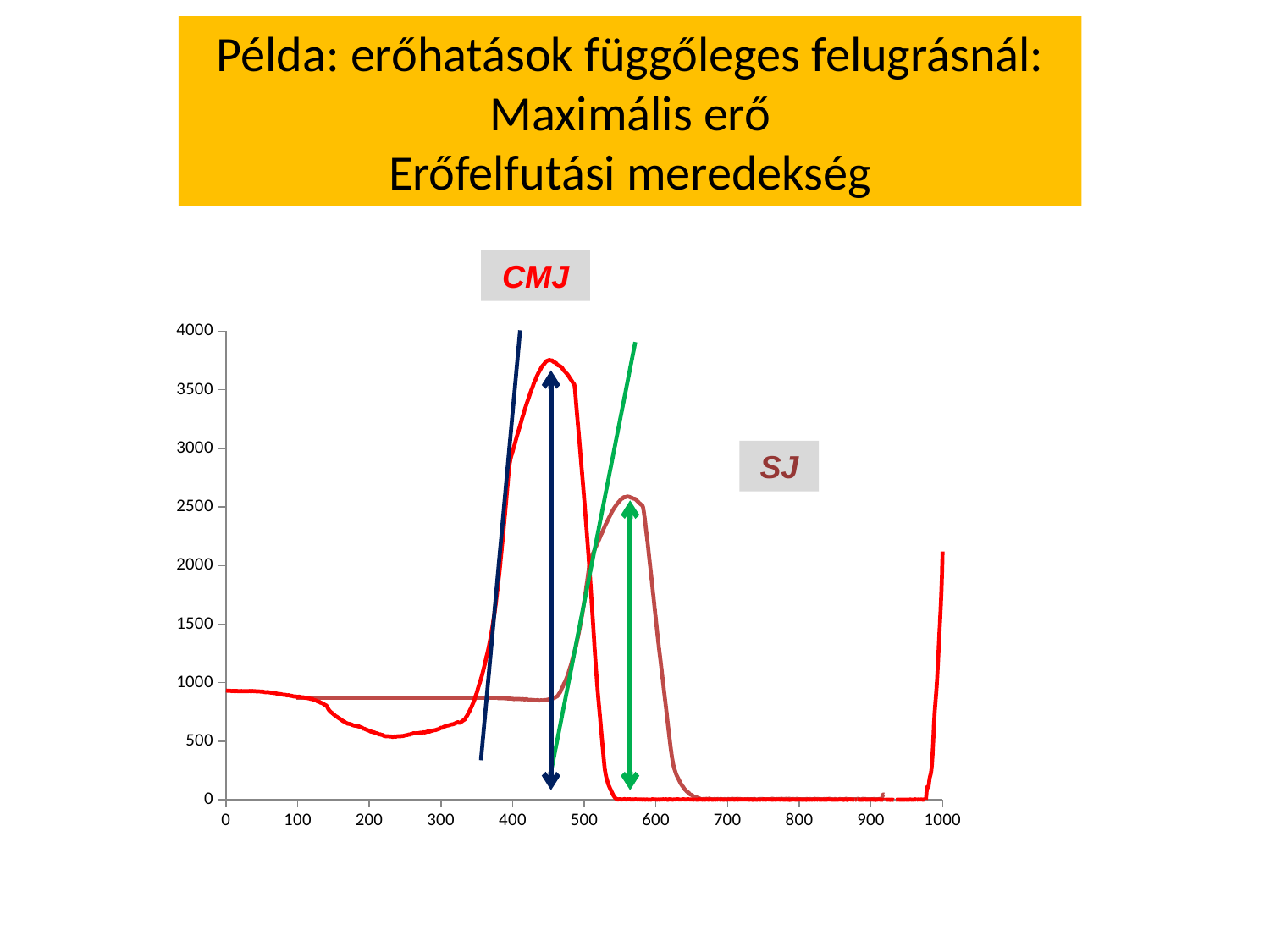
Which two series are labelled on the chart? CMJ and SJ Between x = 100 and x = 250, does the CMJ curve rise or fall? fall Between x = 700 and x = 950, is the value of the CMJ curve greater or less than 500? less Is the peak value of the CMJ curve greater or less than 4000? less How many data series are plotted on the chart? 2 What is the highest value shown on the vertical axis? 4000 Is the peak value of the SJ curve greater or less than 2000? greater What kind of chart is shown on the slide? line chart Which series reaches its peak later along the x axis, CMJ or SJ? SJ Which series reaches the higher peak value, CMJ or SJ? CMJ